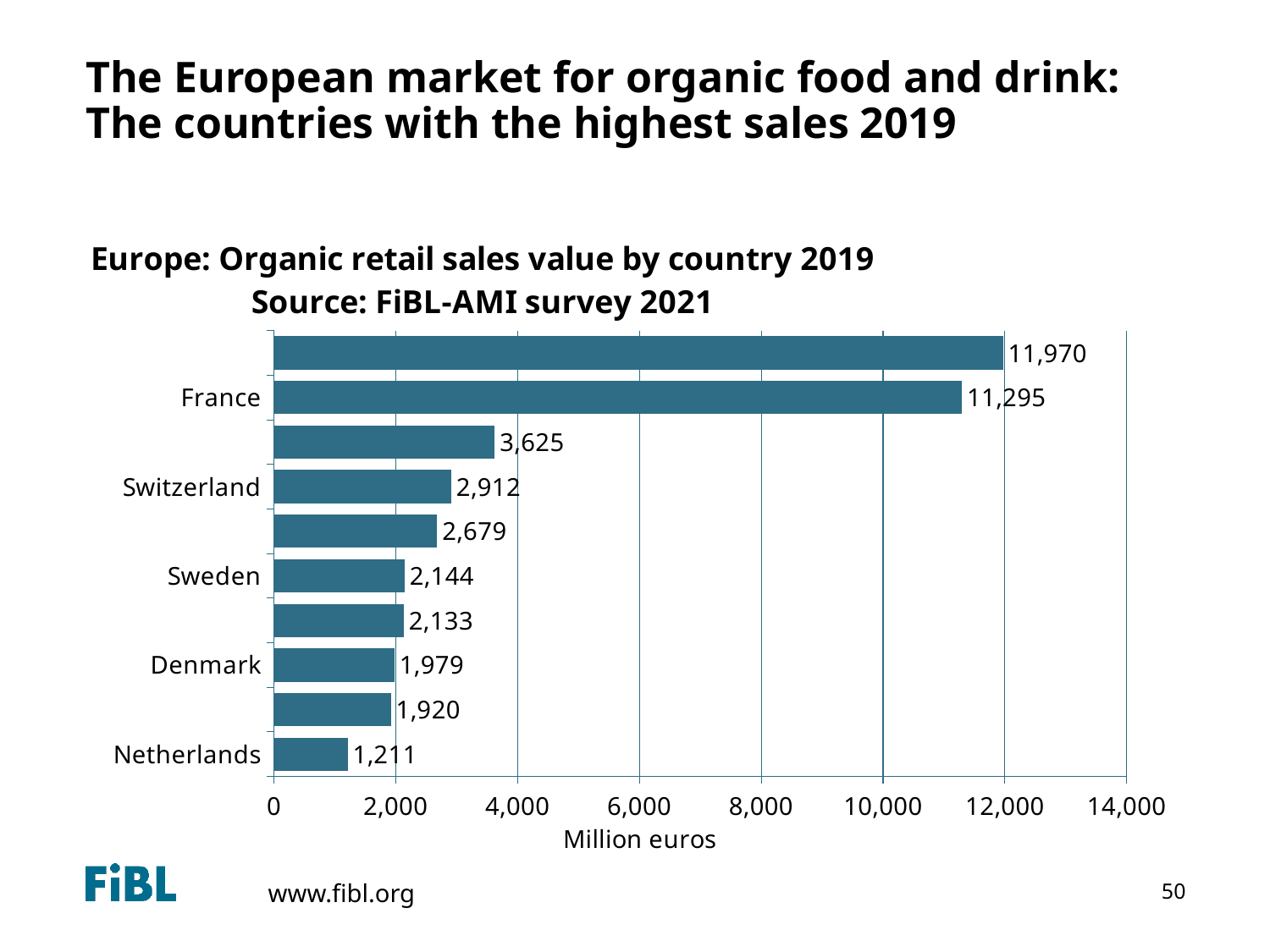
What is the organic retail sales value for Sweden? 2,144 What is the organic retail sales value for Switzerland? 2,912 Which has a higher organic retail sales value, Switzerland or Sweden? Switzerland What is the difference between the values for France and Switzerland? 8,383 What is the organic retail sales value for France? 11,295 How many bars are plotted on the chart? 10 What is the difference between the values for Sweden and Denmark? 165 What is the organic retail sales value for Denmark? 1,979 What kind of chart is shown on the slide? Bar chart What is the organic retail sales value for the Netherlands? 1,211 What is the largest value shown on the chart? 11,970 Which labelled country has the lowest organic retail sales value? Netherlands